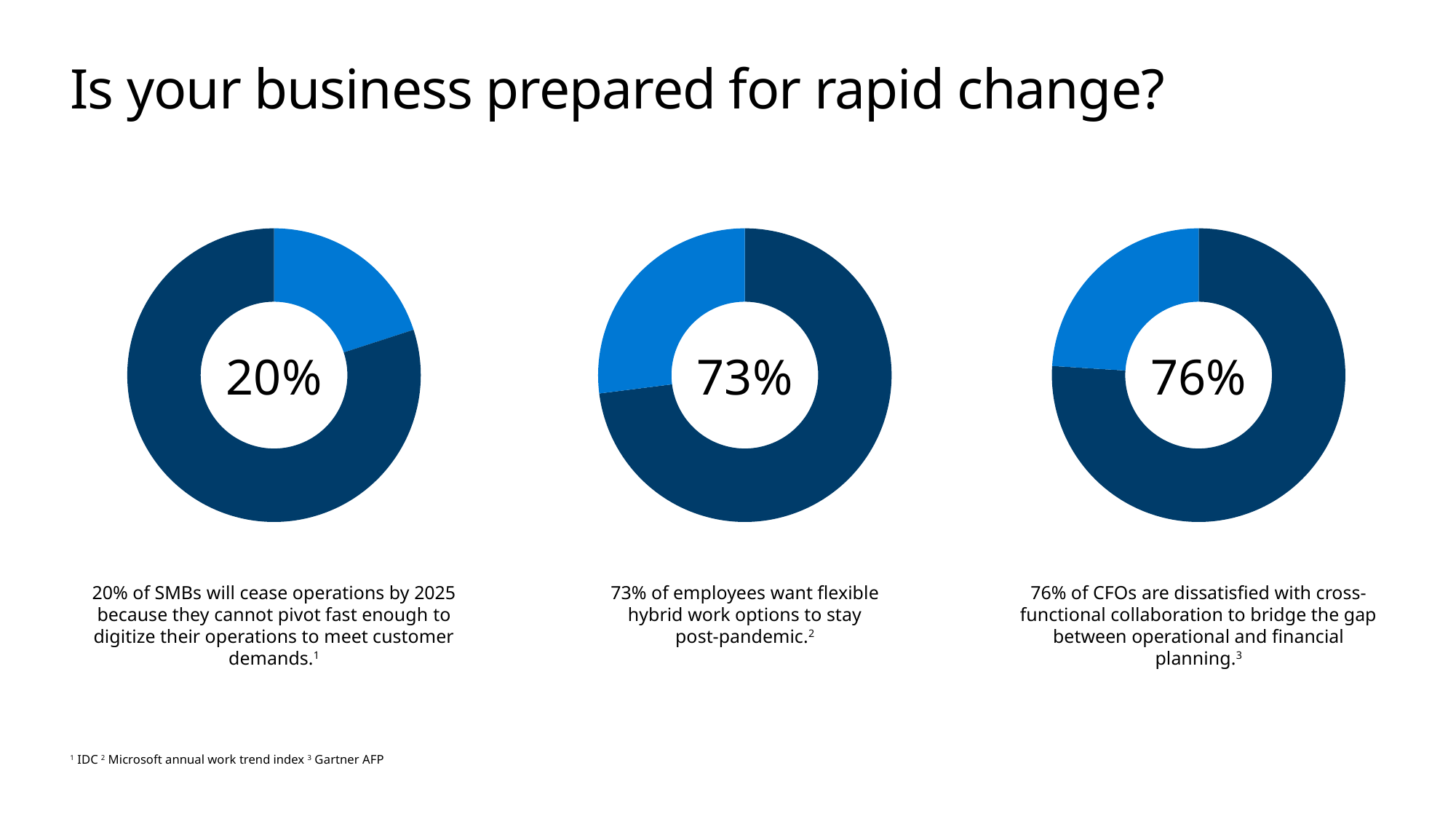
Is the percentage in the middle donut chart larger or smaller than the percentage in the left donut chart? Larger How many slices does each donut chart have? 2 How many donut charts are on the slide? 3 What value is shown in the centre of the middle donut chart? 73% What is the difference between the percentage in the middle donut chart and the percentage in the left donut chart? 53% What is the difference between the percentage in the right donut chart and the percentage in the middle donut chart? 3% Which of the three donut charts shows the lowest percentage? The left chart (20%) What value is shown in the centre of the left donut chart? 20% Which of the three donut charts shows the highest percentage? The right chart (76%) What kind of charts are shown on the slide? Donut charts What value is shown in the centre of the right donut chart? 76% In the left donut chart, what share of the ring is not covered by the light blue slice? 80%